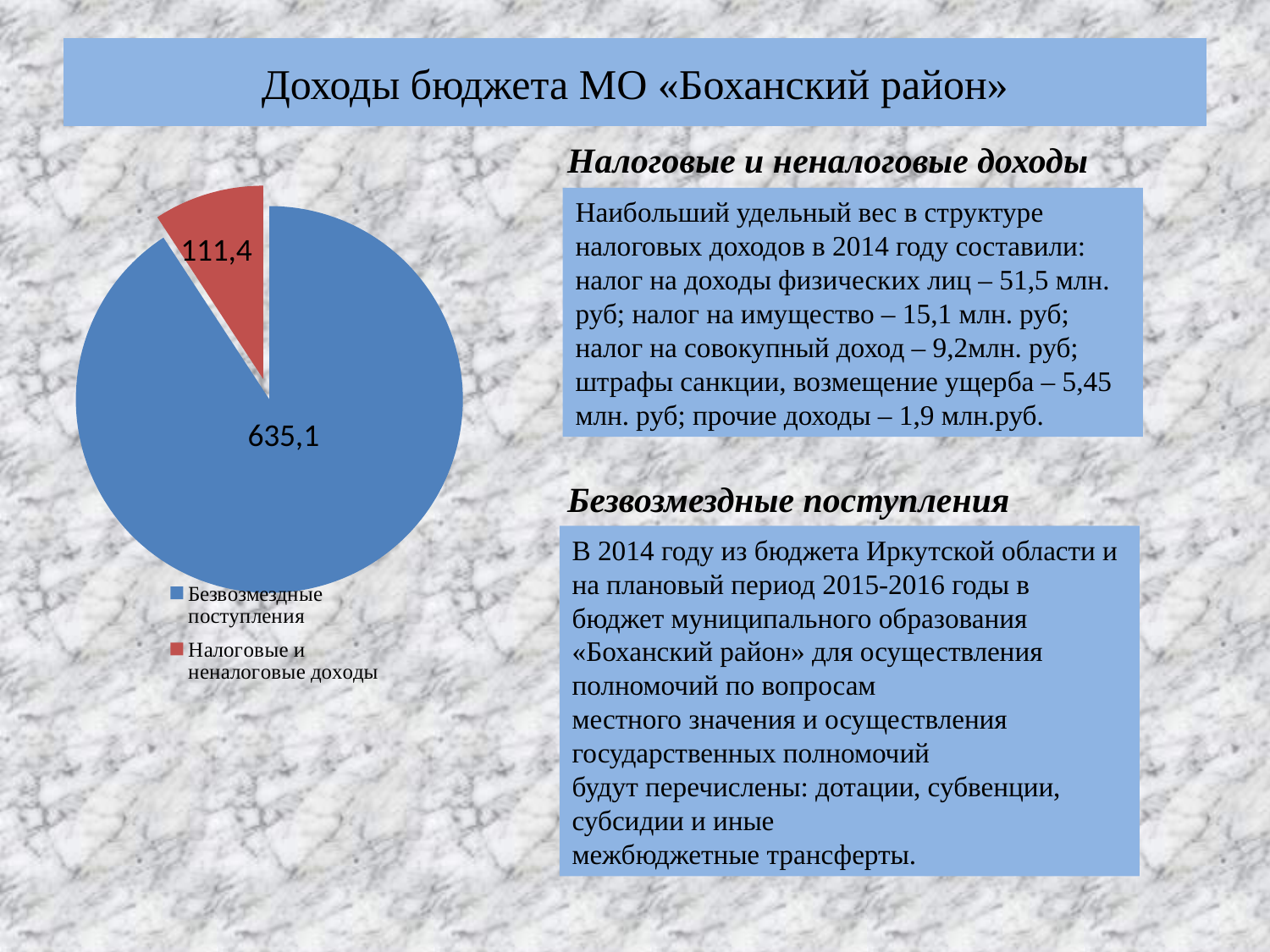
What is the difference between the values for Безвозмездные поступления and Налоговые и неналоговые доходы? 523,7 What colour is the slice for Налоговые и неналоговые доходы? red What is the value shown for Налоговые и неналоговые доходы in the pie chart? 111,4 Which category has the smallest slice in the pie chart? Налоговые и неналоговые доходы What is the value shown for Безвозмездные поступления in the pie chart? 635,1 How many entries does the legend of the pie chart list? 2 What type of chart is shown on the slide? pie chart How many slices does the pie chart have? 2 Which is larger: Безвозмездные поступления or Налоговые и неналоговые доходы? Безвозмездные поступления What is the total of the two values shown in the pie chart? 746,5 Which category has the largest slice in the pie chart? Безвозмездные поступления